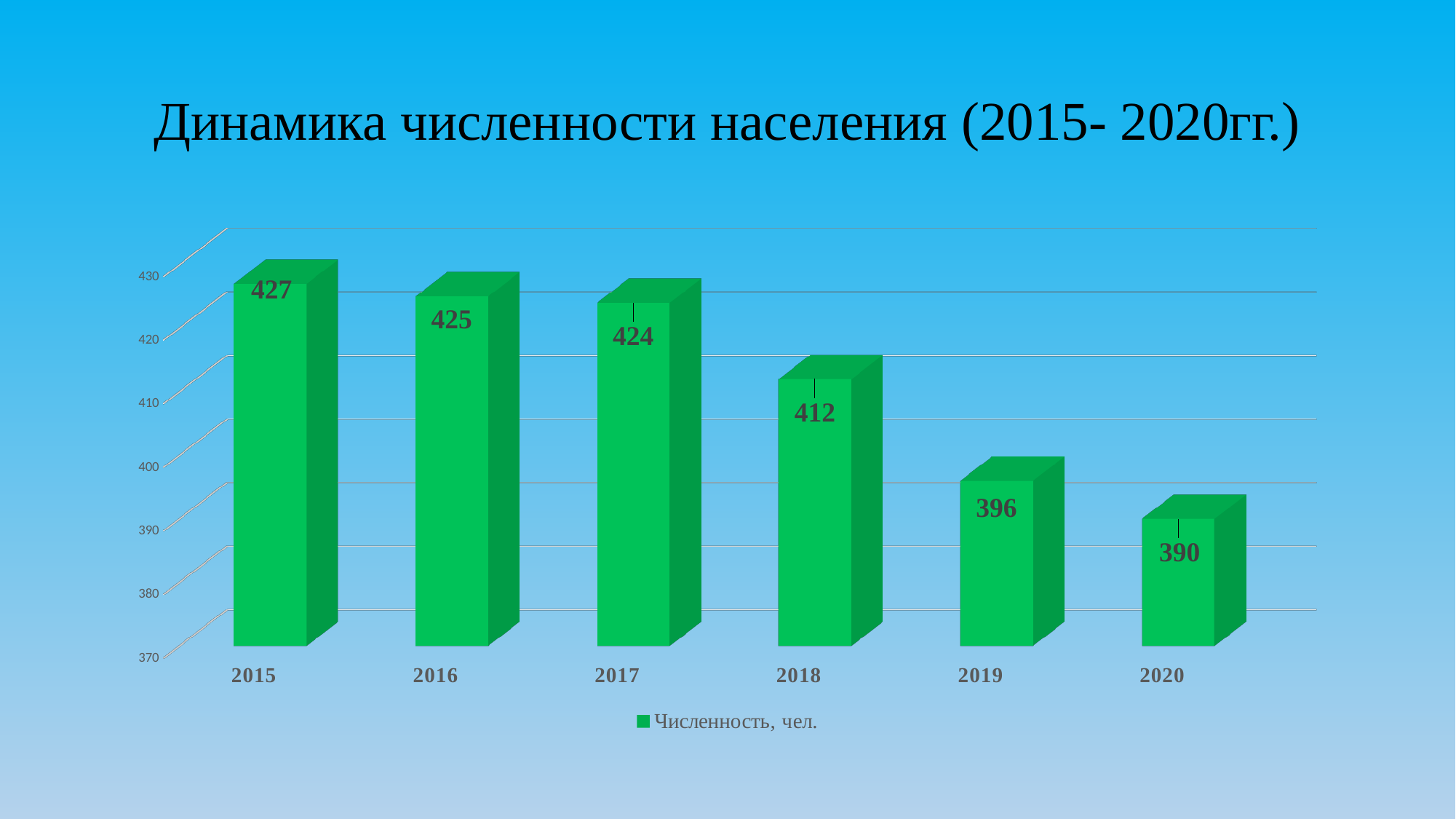
What kind of chart is shown on the slide? bar chart What is the population value for 2018? 412 What is the difference between the population values for 2015 and 2020? 37 How many years are shown on the x axis? 6 What is the difference between the population values for 2018 and 2019? 16 What is the population value for 2020? 390 Do the values rise or fall from 2015 to 2020? fall What is the population value for 2015? 427 Which year has the lowest population value? 2020 How many series does the legend list? 1 Which year has the highest population value? 2015 Which is larger, the value for 2017 or the value for 2019? 2017